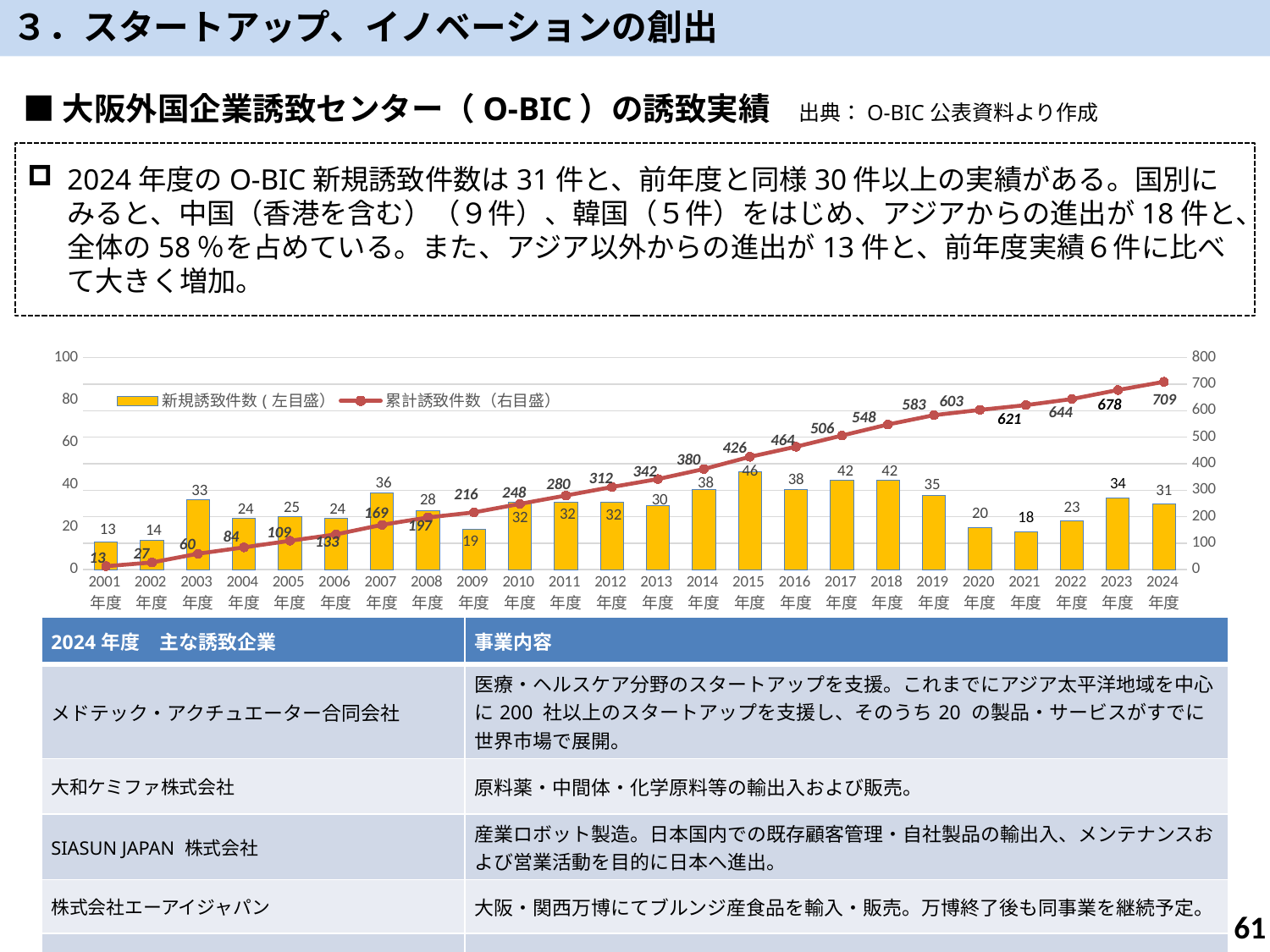
Does the 累計誘致件数 line rise or fall from 2001年度 to 2024年度? Rise Which is larger, the 新規誘致件数 for 2020年度 or for 2021年度? 2020年度 How many years (categories) are shown on the x axis? 24 What is the value of 累計誘致件数 for 2010年度? 248 What kind of chart is this? Combined bar and line chart What is the difference in 新規誘致件数 between 2023年度 and 2024年度? 3 Which year has the highest 新規誘致件数? 2015年度 How many series does the legend list? 2 Which year has the lowest 新規誘致件数? 2001年度 What is the value of 新規誘致件数 for 2024年度? 31 What is the value of 累計誘致件数 for 2024年度? 709 What is the value of 新規誘致件数 for 2015年度? 46